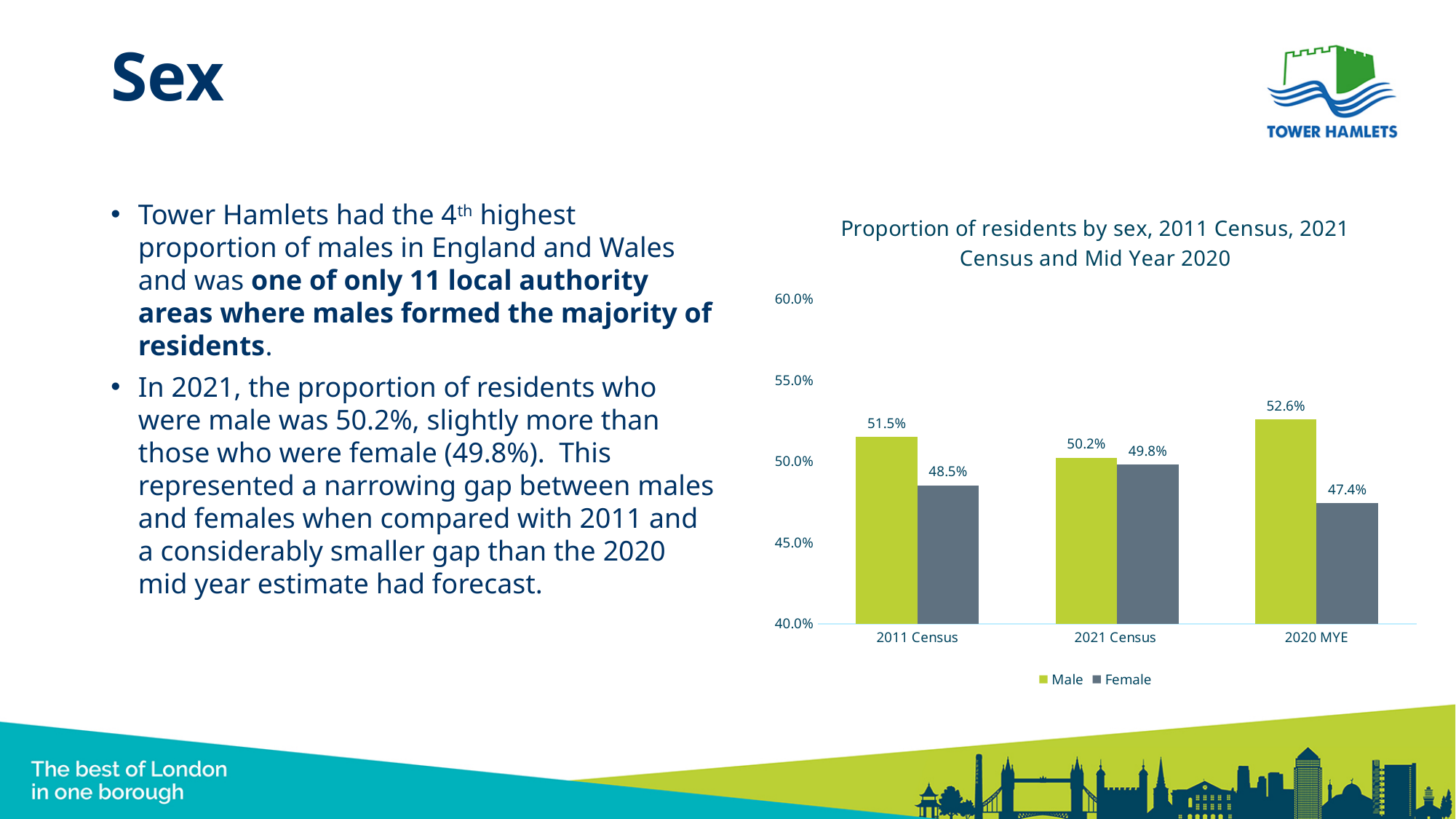
How many categories are shown on the x axis? 3 What is the difference between the Male and Female values for the 2020 MYE? 5.2% How many series does the legend list? 2 Which category has the highest Male value? 2020 MYE What is the Female value for the 2020 MYE? 47.4% What is the Male value for the 2011 Census? 51.5% Which category has the lowest Female value? 2020 MYE What is the difference between the Male and Female values for the 2011 Census? 3.0% What is the Female value for the 2021 Census? 49.8% What kind of chart is shown on the slide? Bar chart What colour are the Male bars? Green Which is larger for the 2021 Census, the Male value or the Female value? Male